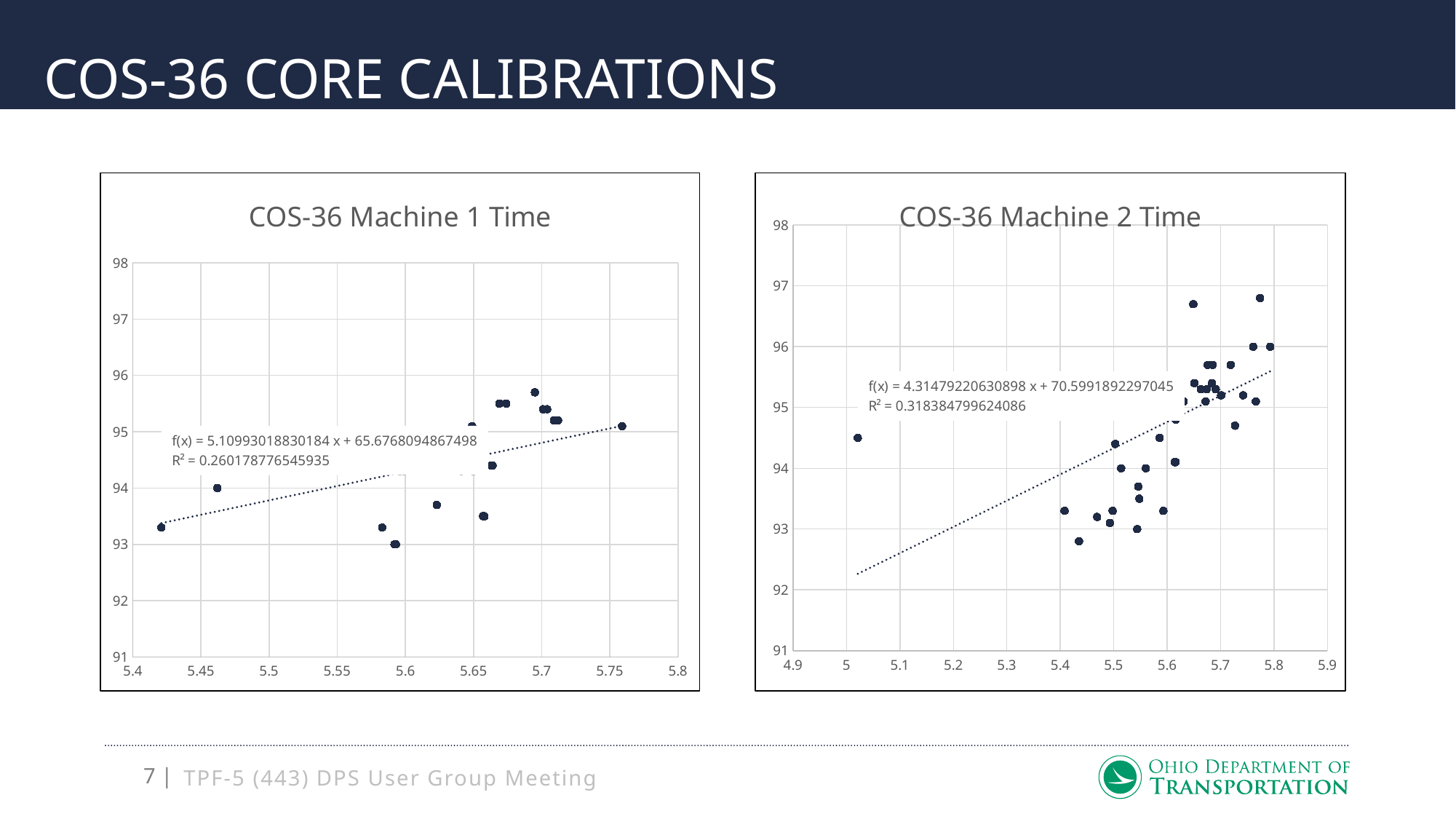
In the COS-36 Machine 2 Time chart, is the value for the highest point (near x = 5.77) greater or less than 96? greater In the COS-36 Machine 2 Time chart, what is the R² value shown for the trendline? 0.318384799624086 In the COS-36 Machine 2 Time chart, does the dotted trendline rise or fall as x increases? rises Which chart has the larger R² value, COS-36 Machine 1 Time or COS-36 Machine 2 Time? COS-36 Machine 2 Time In the COS-36 Machine 1 Time chart, what is the R² value shown for the trendline? 0.260178776545935 In the COS-36 Machine 1 Time chart, what is the slope of the fitted line f(x)? 5.10993018830184 What is the title of the chart on the right side of the slide? COS-36 Machine 2 Time In the COS-36 Machine 2 Time chart, is the value for the leftmost point (near x = 5.02) greater or less than 94? greater In the COS-36 Machine 2 Time chart, what is the intercept of the fitted line f(x)? 70.5991892297045 In the COS-36 Machine 1 Time chart, is the value for the lowest point (near x = 5.59) greater or less than 94? less What kind of chart is the COS-36 Machine 1 Time chart? scatter chart